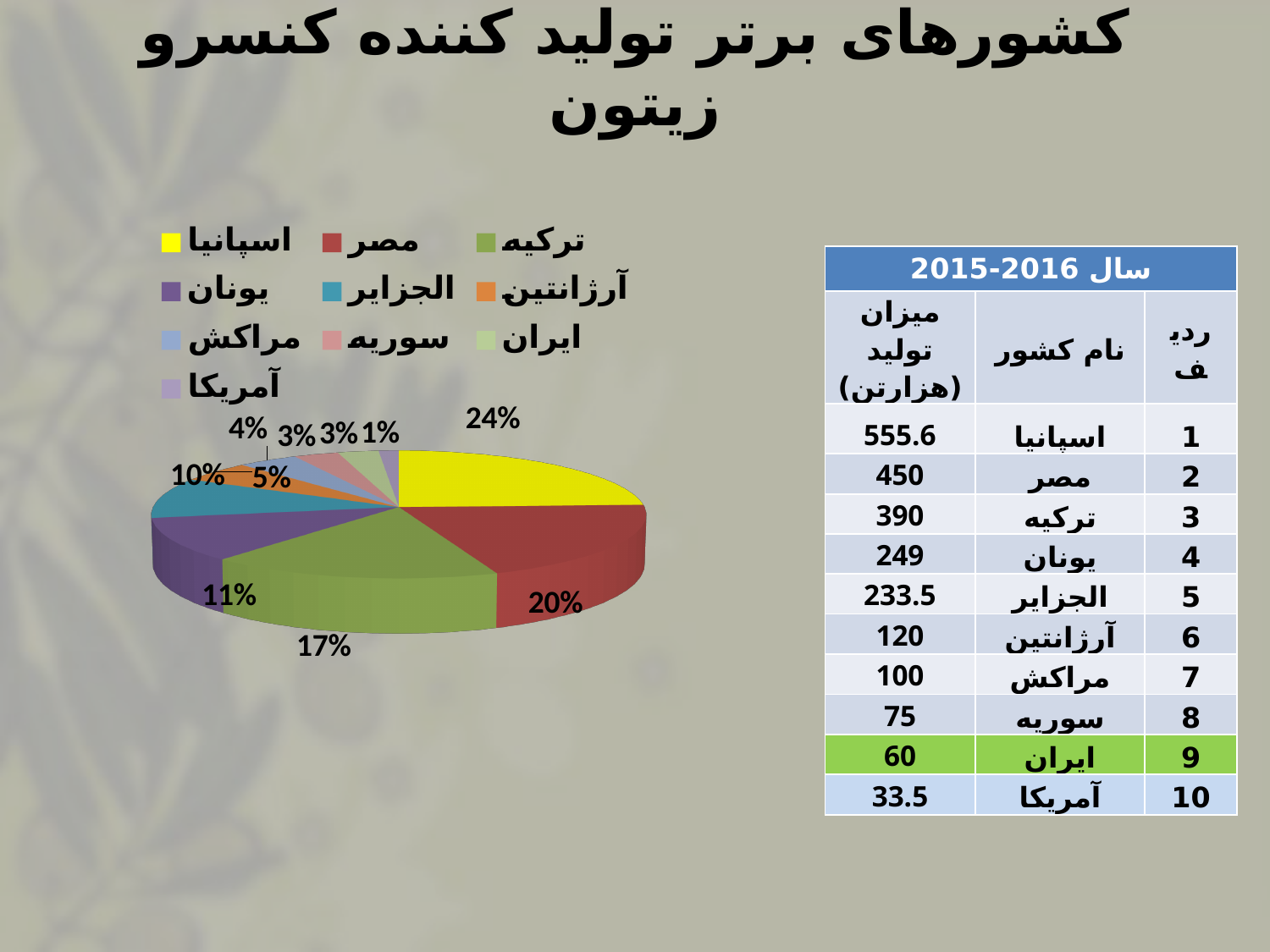
What is the difference in percentage points between the slices for اسپانیا (Spain) and مصر (Egypt)? 4 percentage points What share of the pie does مصر (Egypt) hold? 20% What share of the pie does الجزایر (Algeria) hold? 10% What share of the pie does ترکیه (Turkey) hold? 17% Which country has the smallest slice of the pie? آمریکا (America) Which country has the largest slice of the pie? اسپانیا (Spain) What colour is the slice for اسپانیا (Spain)? yellow How many countries are listed in the pie chart legend? 10 What kind of chart is shown on the slide? pie chart Which slice is larger, یونان (Greece) or الجزایر (Algeria)? یونان (Greece)